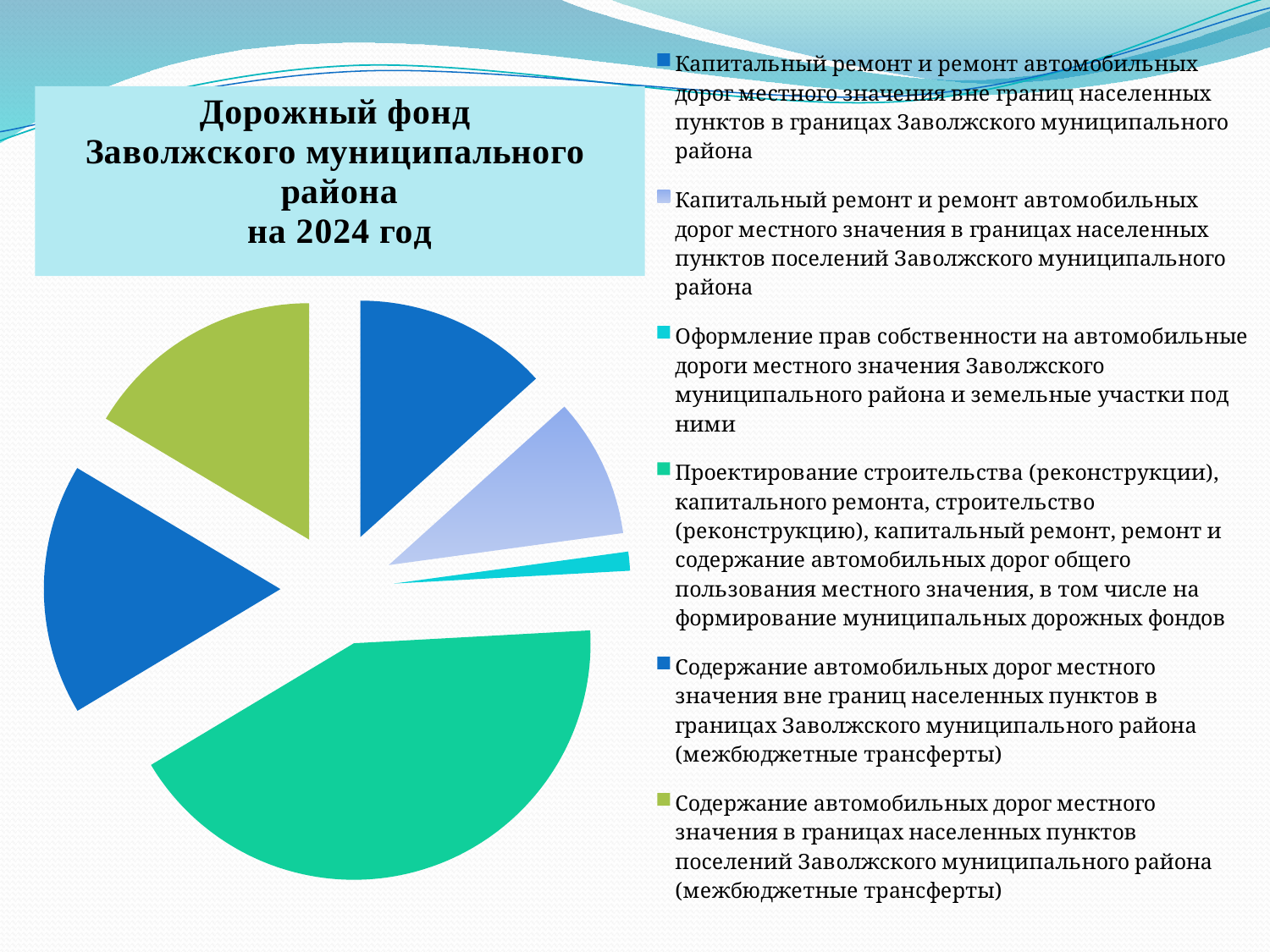
What is the title of the chart on the slide? Дорожный фонд Заволжского муниципального района на 2024 год Which slice is larger: "Капитальный ремонт и ремонт автомобильных дорог местного значения вне границ населенных пунктов в границах Заволжского муниципального района" or "Капитальный ремонт и ремонт автомобильных дорог местного значения в границах населенных пунктов поселений Заволжского муниципального района"? Капитальный ремонт и ремонт автомобильных дорог местного значения вне границ населенных пунктов в границах Заволжского муниципального района What kind of chart is shown on the slide? Pie chart How many slices does the pie chart have? 6 How many entries does the legend of the pie chart list? 6 What colour is the slice for "Оформление прав собственности на автомобильные дороги местного значения Заволжского муниципального района и земельные участки под ними"? Cyan Which slice is larger: "Оформление прав собственности на автомобильные дороги местного значения Заволжского муниципального района и земельные участки под ними" or "Капитальный ремонт и ремонт автомобильных дорог местного значения в границах населенных пунктов поселений Заволжского муниципального района"? Капитальный ремонт и ремонт автомобильных дорог местного значения в границах населенных пунктов поселений Заволжского муниципального района Which category has the smallest slice of the pie chart? Оформление прав собственности на автомобильные дороги местного значения Заволжского муниципального района и земельные участки под ними